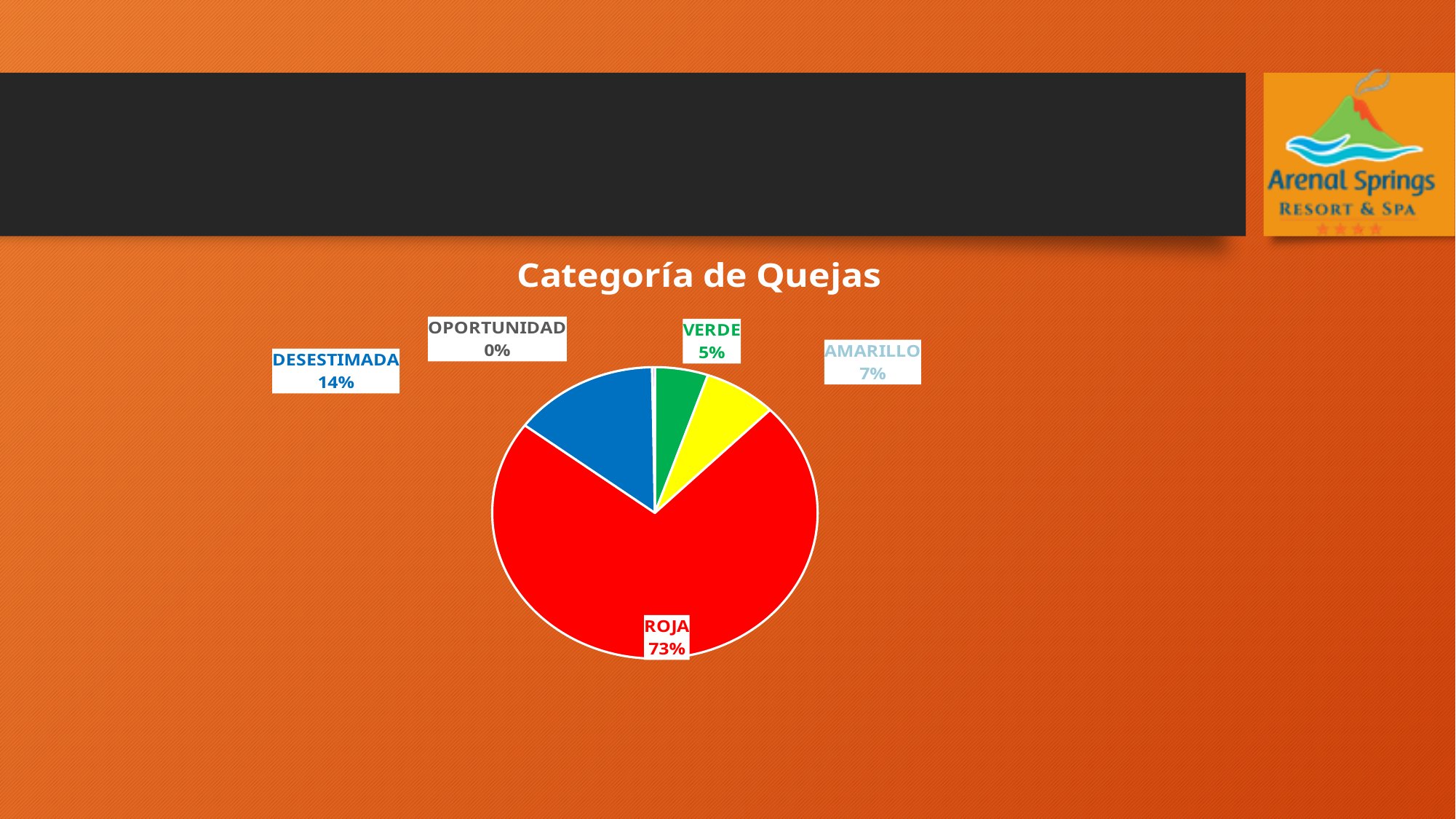
What share of the pie does VERDE represent? 5% What share of the pie does DESESTIMADA represent? 14% What share of the pie does OPORTUNIDAD represent? 0% What is the title of the chart? Categoría de Quejas What share of the pie does ROJA represent? 73% Which is larger, the share for AMARILLO or the share for VERDE? AMARILLO How many categories are shown in the pie chart? 5 What kind of chart is shown on the slide? pie chart Which category has the smallest share of the pie? OPORTUNIDAD Which category has the largest share of the pie? ROJA What is the difference in percentage points between ROJA and DESESTIMADA? 59 What share of the pie does AMARILLO represent? 7%